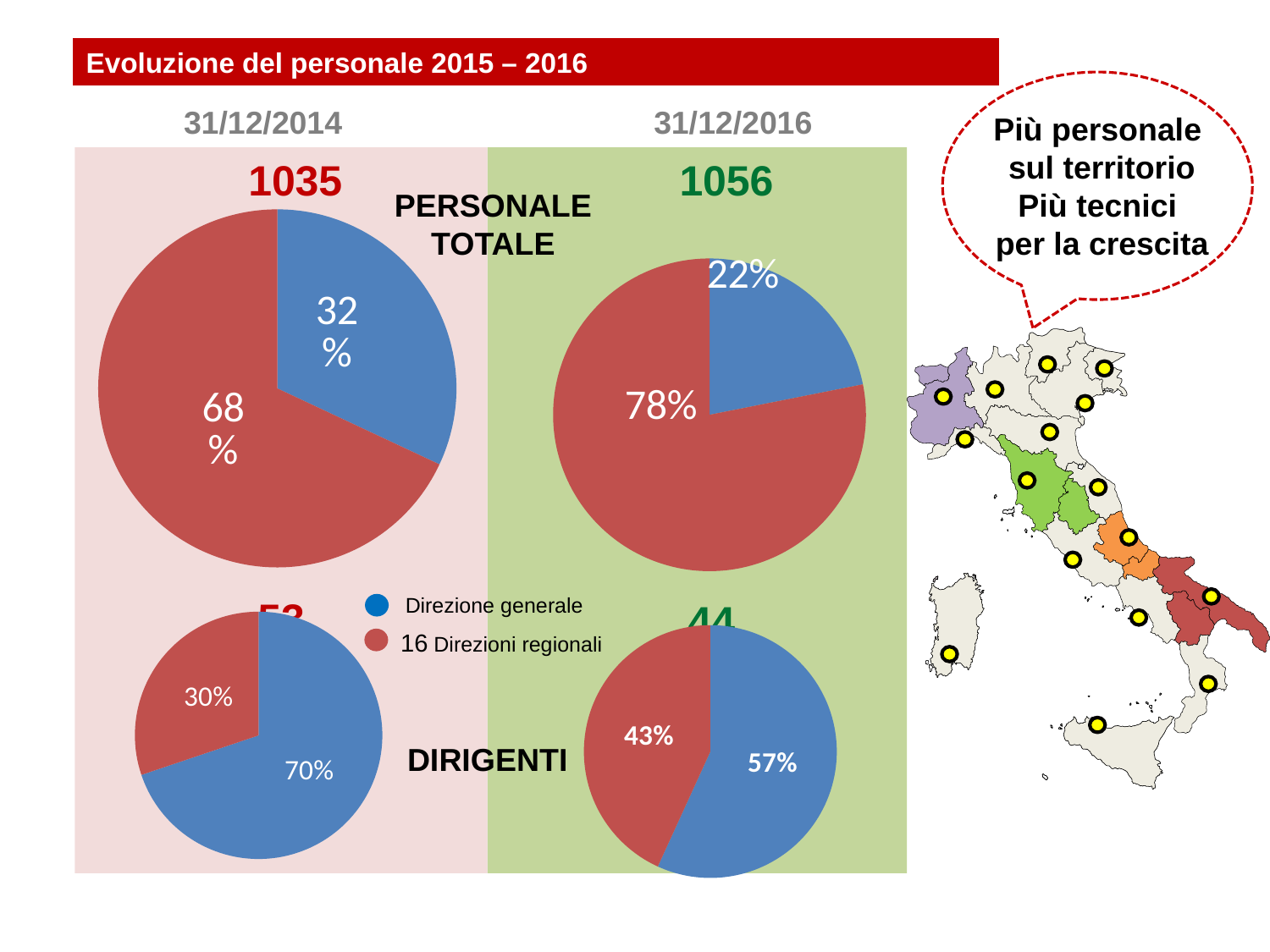
In the Personale totale pie chart for 31/12/2016, what share is 16 Direzioni regionali? 78% In the Personale totale pie chart for 31/12/2014, what share is 16 Direzioni regionali? 68% What kind of chart is used to show the Personale totale breakdown? Pie chart What total Personale totale figure is shown above the pie chart for 31/12/2014? 1035 In the Personale totale pie chart for 31/12/2016, what share is Direzione generale? 22% How many entries does the legend list for the pie charts? 2 What is the difference between the Direzione generale share in the Dirigenti pie for 31/12/2014 and the Dirigenti pie for 31/12/2016? 13% What total Personale totale figure is shown above the pie chart for 31/12/2016? 1056 In the Dirigenti pie chart for 31/12/2016, which slice is larger, Direzione generale or 16 Direzioni regionali? Direzione generale